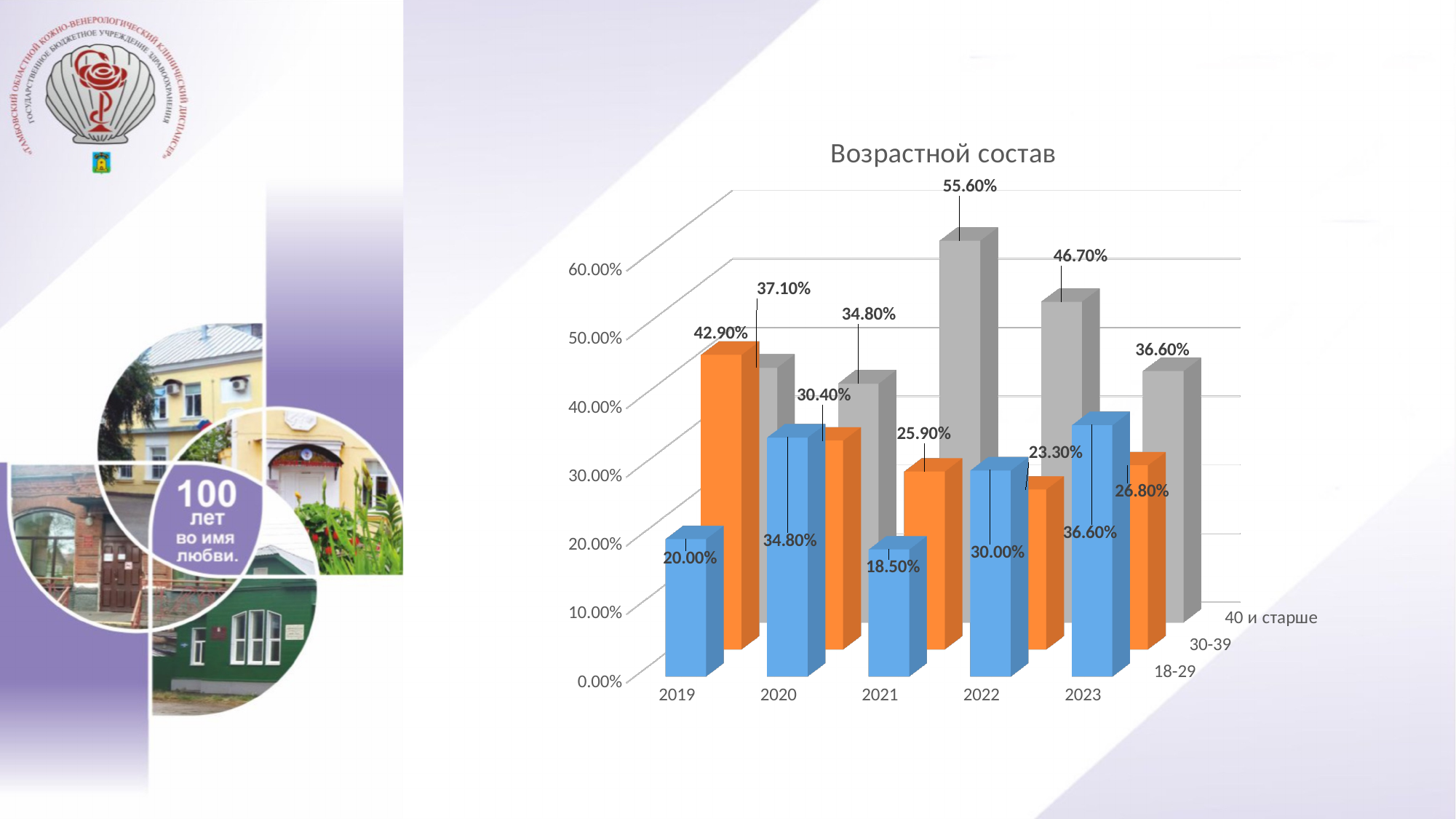
What is the title of the chart? Возрастной состав In which year is the value for the 40 и старше group highest? 2021 What is the difference between the 40 и старше value in 2021 and in 2022? 8.90% In which year is the value for the 18-29 group lowest? 2021 How many years are shown on the x axis of the chart? 5 Does the value for the 18-29 group rise or fall from 2021 to 2023? rise Which age group is shown with grey bars? 40 и старше What type of chart is shown on the slide? bar chart What is the value for the 18-29 group in 2019? 20.00% Which is larger in 2019: the value for 30-39 or the value for 40 и старше? 30-39 What is the value for the 30-39 group in 2022? 23.30% What is the value for the 40 и старше group in 2021? 55.60%